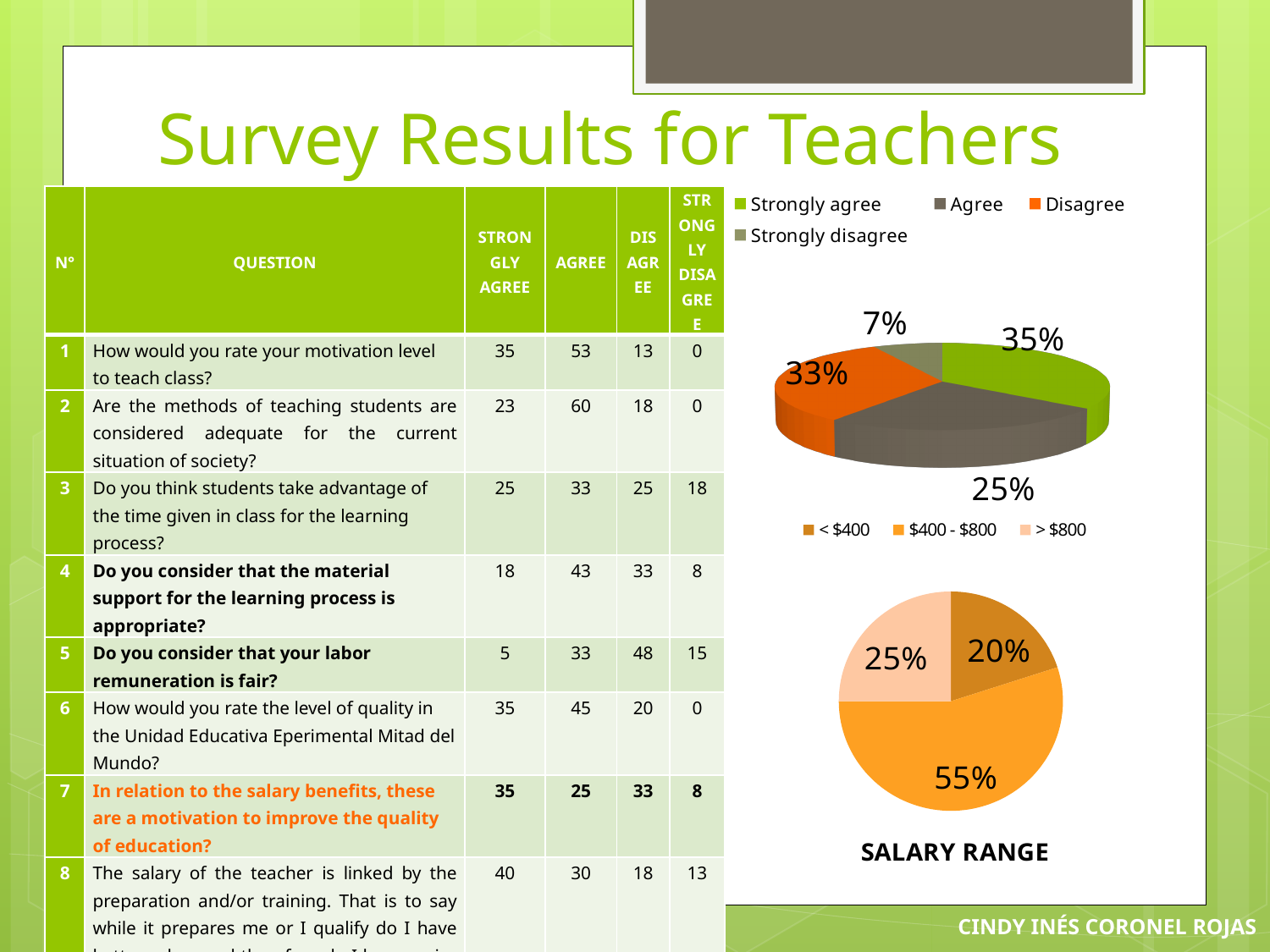
In the SALARY RANGE chart, what percentage is shown for < $400? 20% In the upper pie chart, what percentage is shown for Disagree? 33% In the SALARY RANGE chart, which salary range has the largest share? $400 - $800 In the upper pie chart, how many categories does the legend list? 4 What kind of chart is the SALARY RANGE chart? Pie chart In the upper pie chart, which category has the smallest share? Strongly disagree In the SALARY RANGE chart, which is larger, the share for > $800 or the share for < $400? > $800 In the upper pie chart, what percentage is shown for Strongly disagree? 7% In the upper pie chart, which category has the largest share? Strongly agree In the upper pie chart (with the Strongly agree / Agree / Disagree / Strongly disagree legend), what percentage is shown for Strongly agree? 35% In the upper pie chart, what is the difference between the Agree share and the Strongly disagree share? 18% In the SALARY RANGE chart, what percentage is shown for $400 - $800? 55%